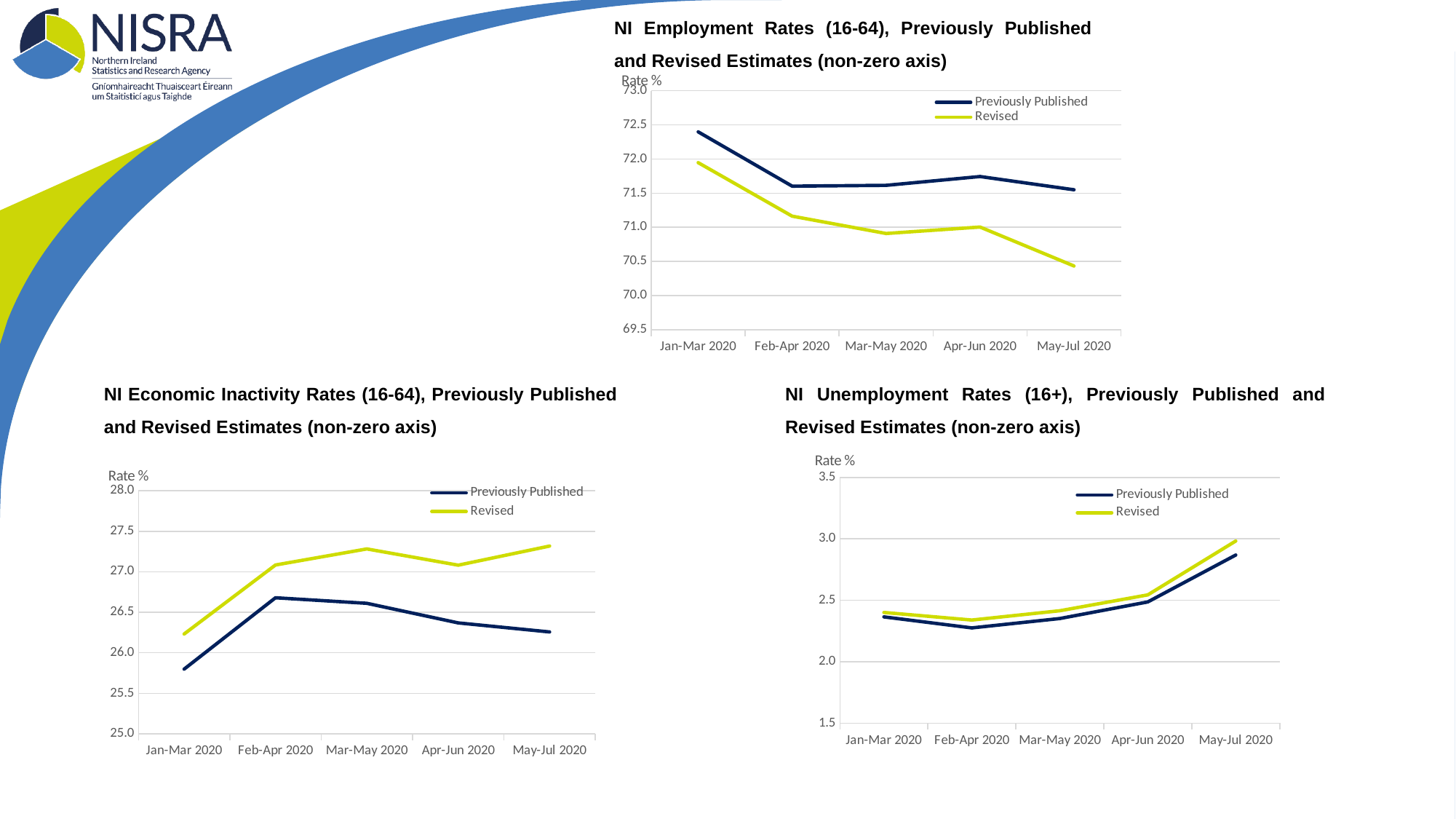
In the 'NI Employment Rates (16-64)' chart, in which period is the Revised series at its lowest? May-Jul 2020 In the 'NI Employment Rates (16-64)' chart, how many series does the legend list? 2 In the 'NI Employment Rates (16-64)' chart, which series is higher in Mar-May 2020, Previously Published or Revised? Previously Published In the 'NI Employment Rates (16-64)' chart, is the Previously Published value for Jan-Mar 2020 greater or less than 72.0? greater In the 'NI Unemployment Rates (16+)' chart, does the Previously Published series rise or fall from Feb-Apr 2020 to May-Jul 2020? rise In the 'NI Employment Rates (16-64)' chart, how many time periods are shown on the x axis? 5 In the 'NI Economic Inactivity Rates (16-64)' chart, in which period is the Previously Published series at its lowest? Jan-Mar 2020 In the 'NI Employment Rates (16-64)' chart, is the Revised value for May-Jul 2020 greater or less than 71.0? less In the 'NI Economic Inactivity Rates (16-64)' chart, which series is higher in Feb-Apr 2020, Previously Published or Revised? Revised What kind of chart is the 'NI Employment Rates (16-64)' chart at the top right? line chart In the 'NI Economic Inactivity Rates (16-64)' chart, is the Revised value for May-Jul 2020 greater or less than 27.0? greater